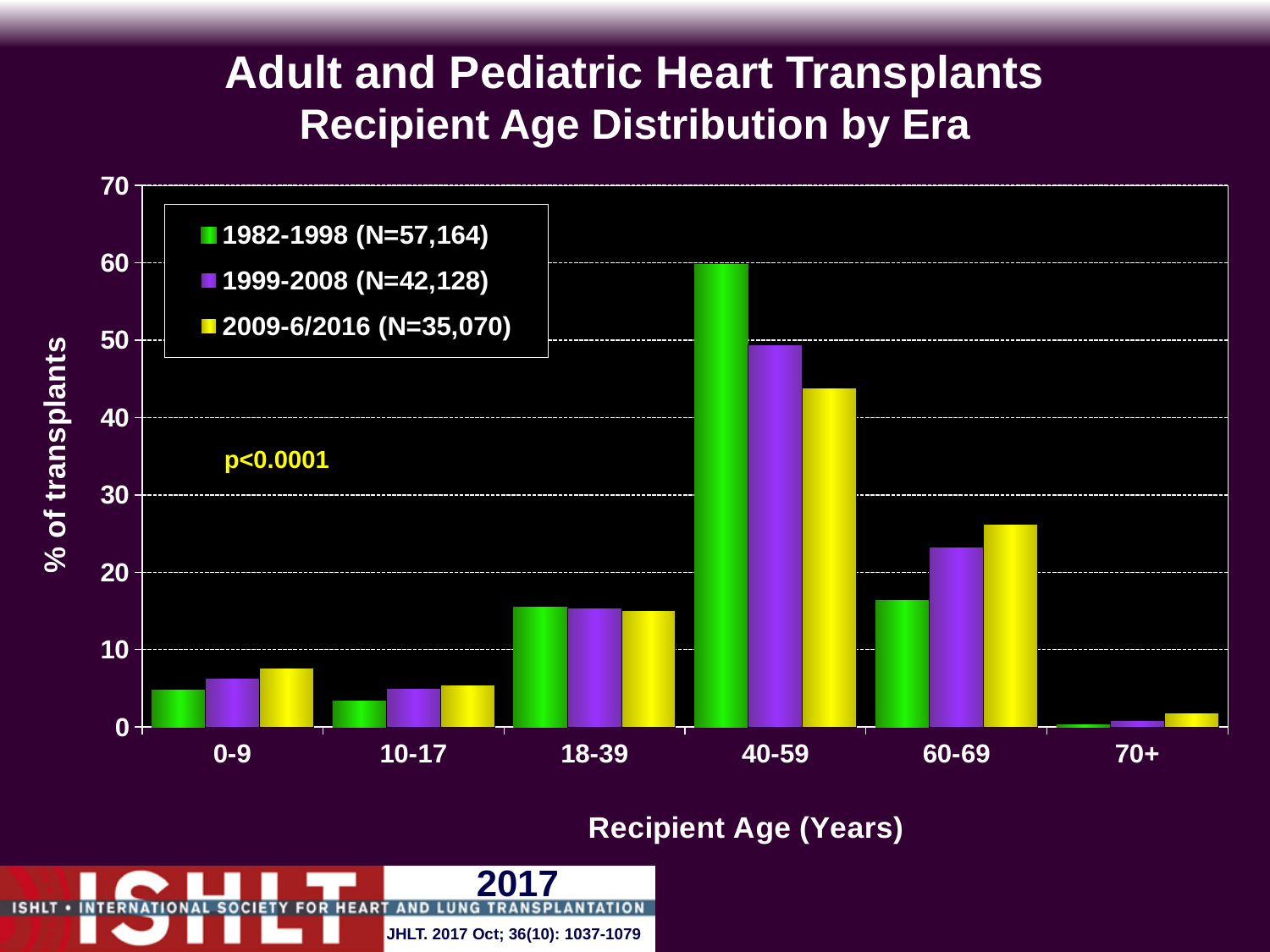
Is the value for the 1982-1998 era in the 40-59 age group greater or less than 50? greater Is the value for the 1999-2008 era in the 60-69 age group greater or less than 20? greater In the 60-69 age group, which era has the larger percentage of transplants: 1982-1998 or 2009-6/2016? 2009-6/2016 How many recipient age groups are shown on the x axis? 6 According to the legend, what is the N for the 1999-2008 era? 42,128 In the 40-59 age group, which era has the larger percentage of transplants: 1982-1998 or 1999-2008? 1982-1998 How many series (eras) does the legend list? 3 What kind of chart is shown on the slide? bar chart For the 1982-1998 era, which recipient age group has the highest percentage of transplants? 40-59 Is the value for the 2009-6/2016 era in the 0-9 age group greater or less than 10? less For the 2009-6/2016 era, which recipient age group has the lowest percentage of transplants? 70+